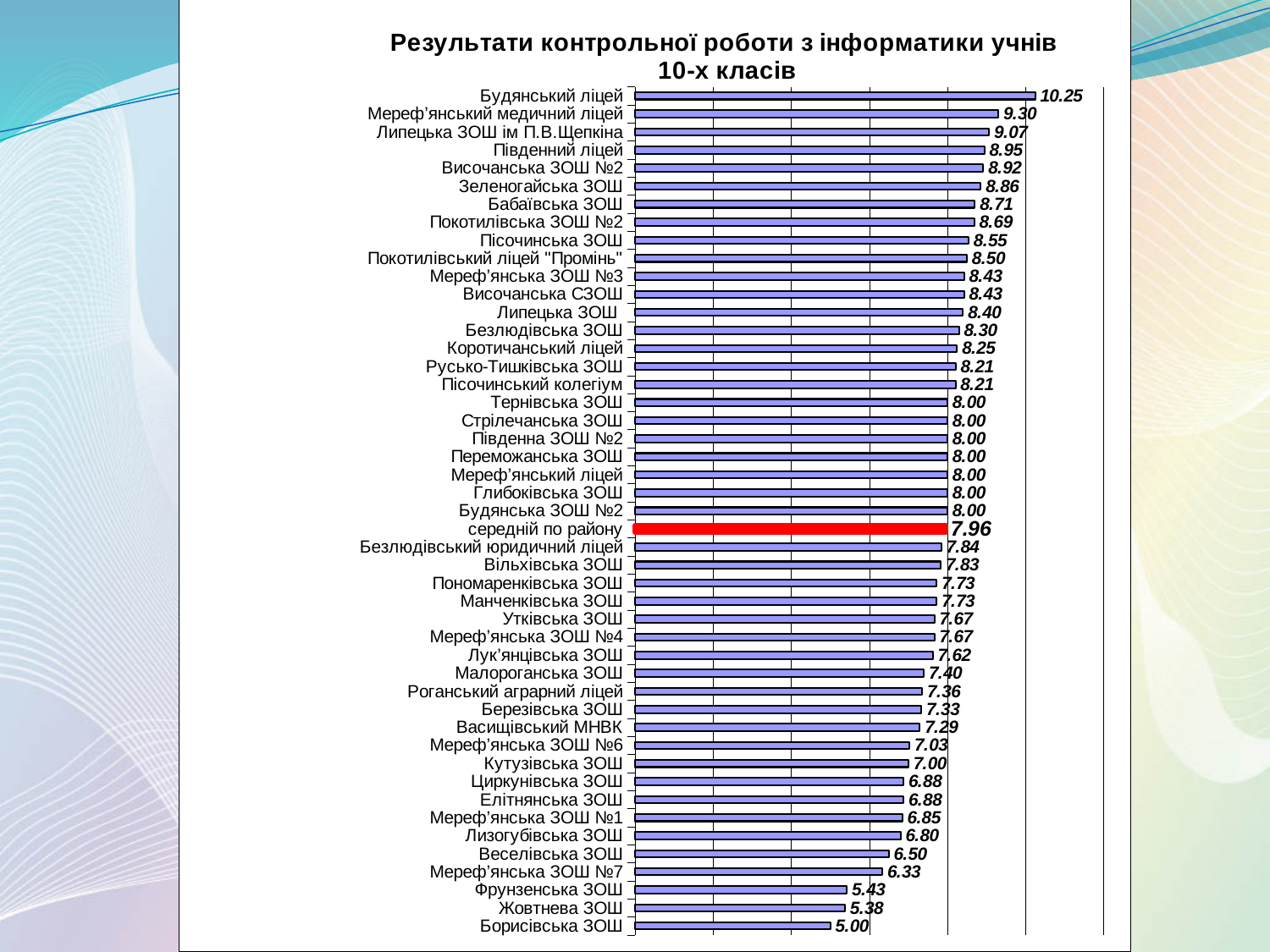
Which bar is highlighted in red on the chart? середній по району What is the difference between the values for Мереф'янський медичний ліцей and середній по району? 1.34 What kind of chart is shown on the slide? bar chart What is the value for Липецька ЗОШ ім П.В.Щепкіна? 9.07 Which is larger, the value for Веселівська ЗОШ or the value for Жовтнева ЗОШ? Веселівська ЗОШ Which is larger, the value for Пісочинська ЗОШ or the value for Кутузівська ЗОШ? Пісочинська ЗОШ What is the value for Будянський ліцей? 10.25 What is the value for середній по району? 7.96 Which category has the highest value? Будянський ліцей What is the difference between the values for Будянський ліцей and Борисівська ЗОШ? 5.25 What is the value for Мереф'янська ЗОШ №7? 6.33 Which category has the lowest value? Борисівська ЗОШ